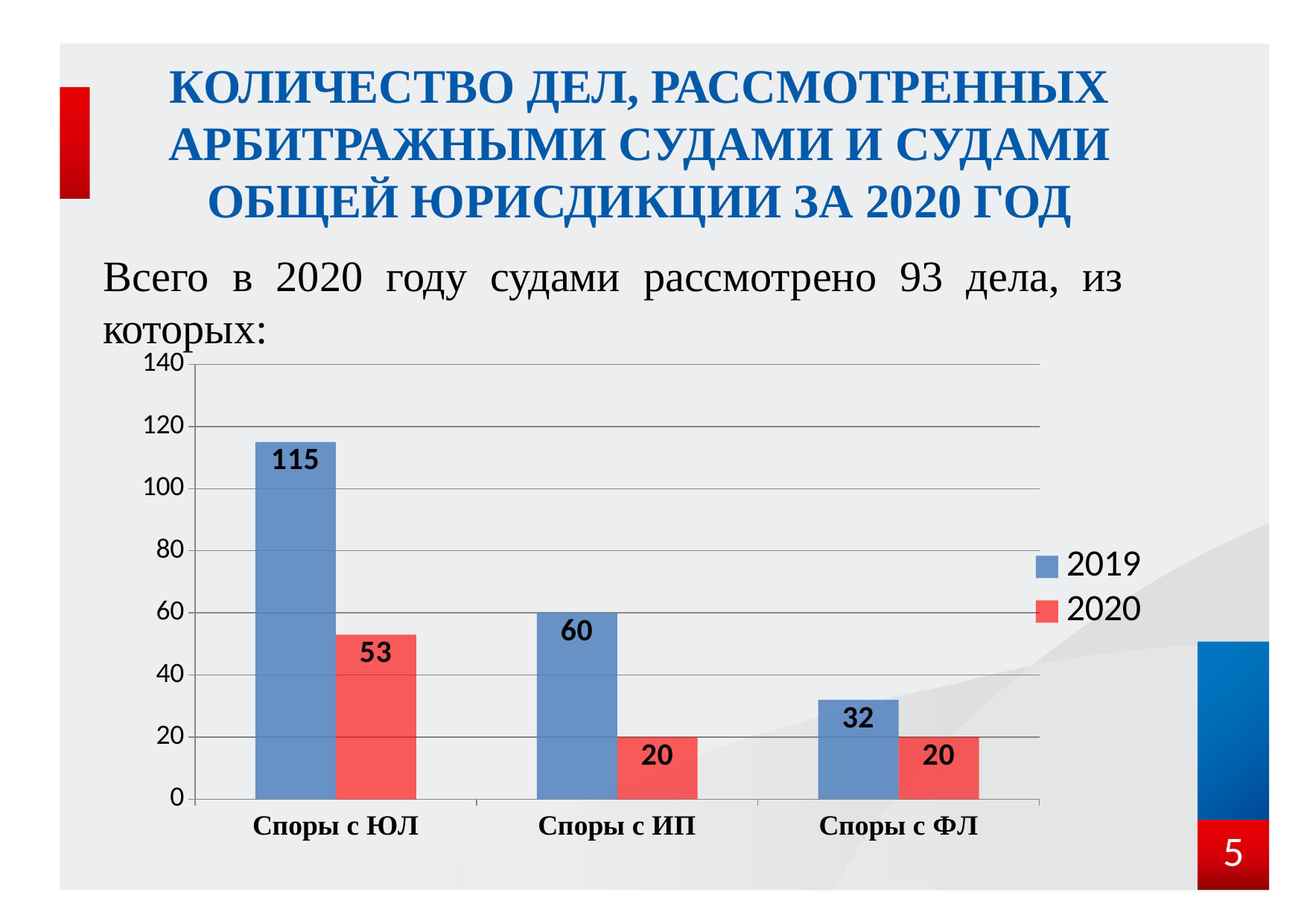
Which colour represents the 2020 series in the legend? red What is the value for 2020 in the category Споры с ИП? 20 What is the difference between the 2019 and 2020 values for Споры с ЮЛ? 62 What is the difference between the 2019 values for Споры с ИП and Споры с ФЛ? 28 What is the value for 2019 in the category Споры с ЮЛ? 115 Which category has the highest value for 2020? Споры с ЮЛ Which is larger: the 2020 value for Споры с ЮЛ or the 2019 value for Споры с ФЛ? 2020 value for Споры с ЮЛ What kind of chart is shown on the slide? bar chart How many categories are shown on the x axis? 3 Which category has the lowest value for 2019? Споры с ФЛ What is the value for 2019 in the category Споры с ФЛ? 32 How many series does the legend list? 2